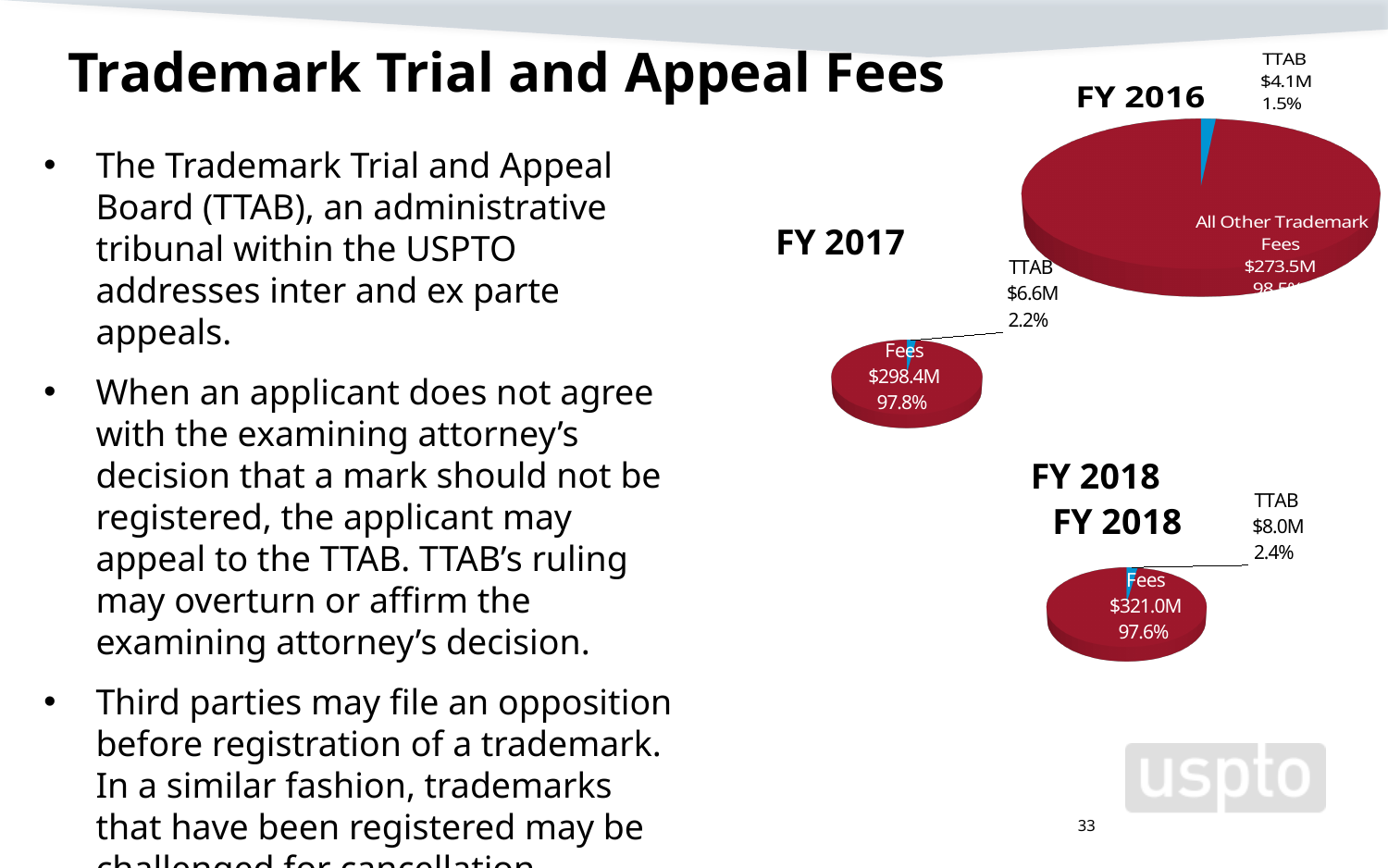
In the FY 2017 pie chart, what is the value of the Fees slice? $298.4M In the FY 2018 pie chart, what share of the pie does the Fees slice represent? 97.6% What is the difference between the TTAB value in the FY 2018 pie chart and the TTAB value in the FY 2017 pie chart? $1.4M In the FY 2018 pie chart, what is the value of the TTAB slice? $8.0M In the FY 2016 pie chart, what share of the pie does the TTAB slice represent? 1.5% In the FY 2016 pie chart, what is the value of the All Other Trademark Fees slice? $273.5M In the FY 2017 pie chart, what share of the pie does the TTAB slice represent? 2.2% In the FY 2016 pie chart, what is the value of the TTAB slice? $4.1M How many slices does the FY 2018 pie chart have? 2 Which is larger, the TTAB value in the FY 2018 pie chart or the TTAB value in the FY 2017 pie chart? FY 2018 In the FY 2017 pie chart, what is the value of the TTAB slice? $6.6M What kind of chart is used to show the FY 2016 fees? Pie chart